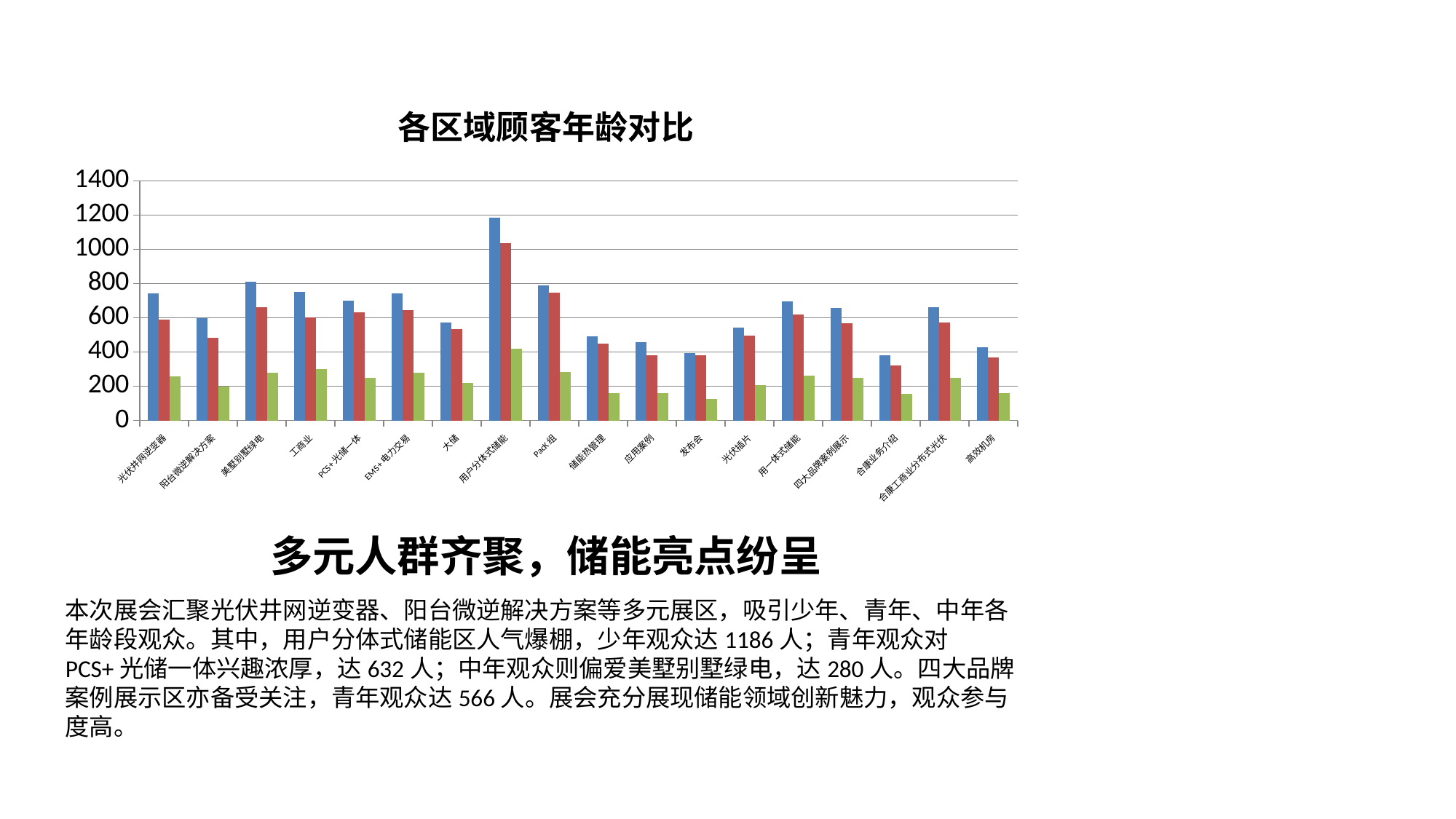
What type of chart is shown on the slide? Bar chart Is the green bar for 发布会 greater or less than 200? less Is the blue bar for 用户分体式储能 greater or less than 1000? greater According to the slide, how many 少年 visitors did the 用户分体式储能 area attract? 1186 人 How many bars are plotted for each category in the chart? 3 Which category has the tallest blue bar in the chart? 用户分体式储能 Is the red bar for 合康业务介绍 greater or less than 400? less Which has the taller blue bar, 大储 or 用户分体式储能? 用户分体式储能 What is the title of the chart? 各区域顾客年龄对比 Which has the taller red bar, 工商业 or 应用案例? 工商业 Which category has the shortest green bar in the chart? 发布会 How many categories (exhibition areas) are shown on the x axis of the chart? 18